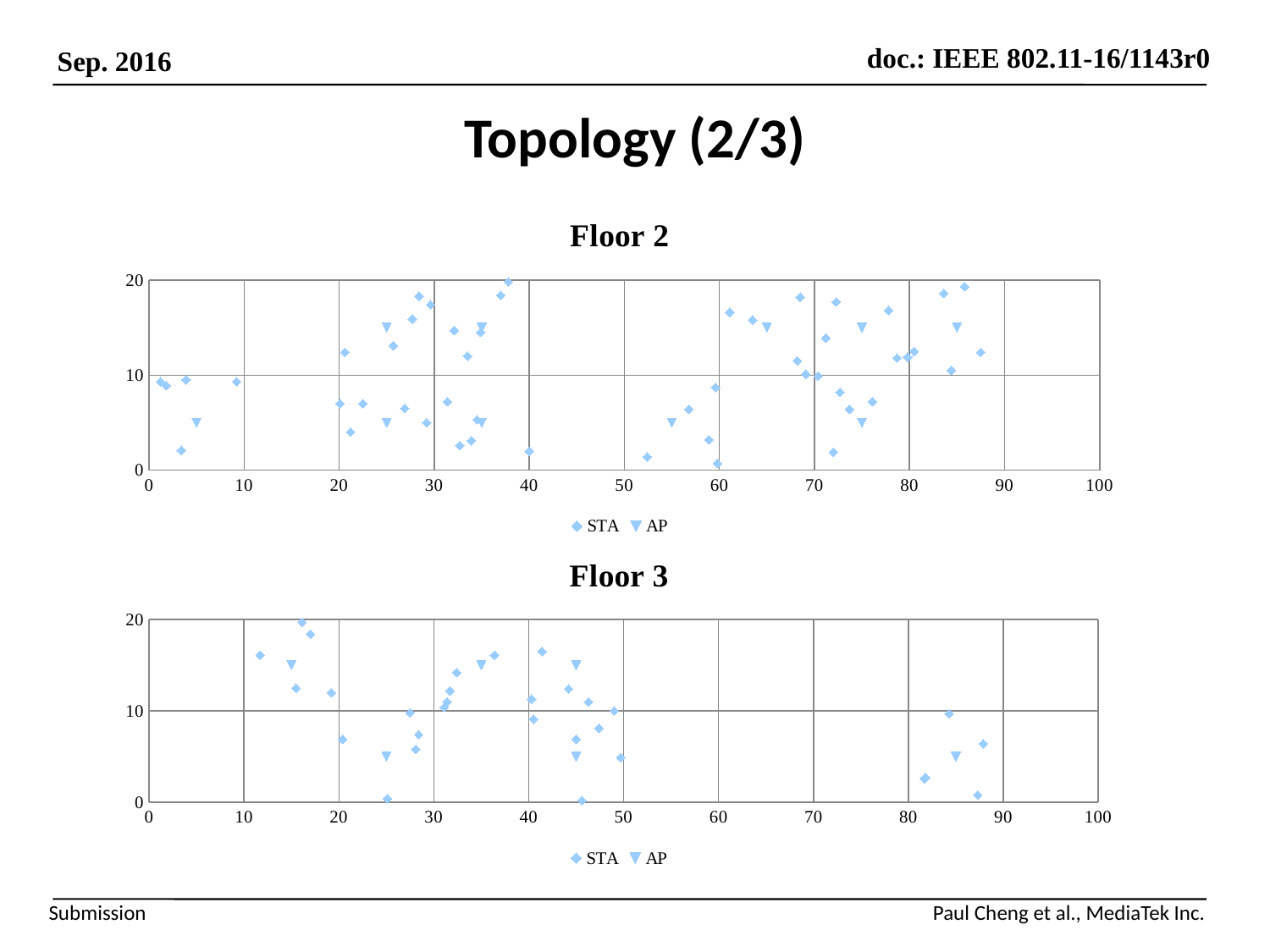
In the Floor 2 chart, is the AP marker located near x=85 above or below the y value of 10? above In the Floor 2 chart, is the AP marker located near x=5 above or below the y value of 10? below How many AP markers (triangles) are plotted in the Floor 3 chart? 6 In the Floor 3 chart, is the AP marker located near x=85 above or below the y value of 10? below What is the title of the upper chart on the slide? Floor 2 What kind of chart is the Floor 2 chart? scatter chart In the Floor 3 chart, are there any STA markers plotted between x=60 and x=80? No How many series does the legend of the Floor 3 chart list? 2 How many series does the legend of the Floor 2 chart list? 2 What are the two series named in the legend of the Floor 3 chart? STA and AP What kind of chart is the Floor 3 chart? scatter chart